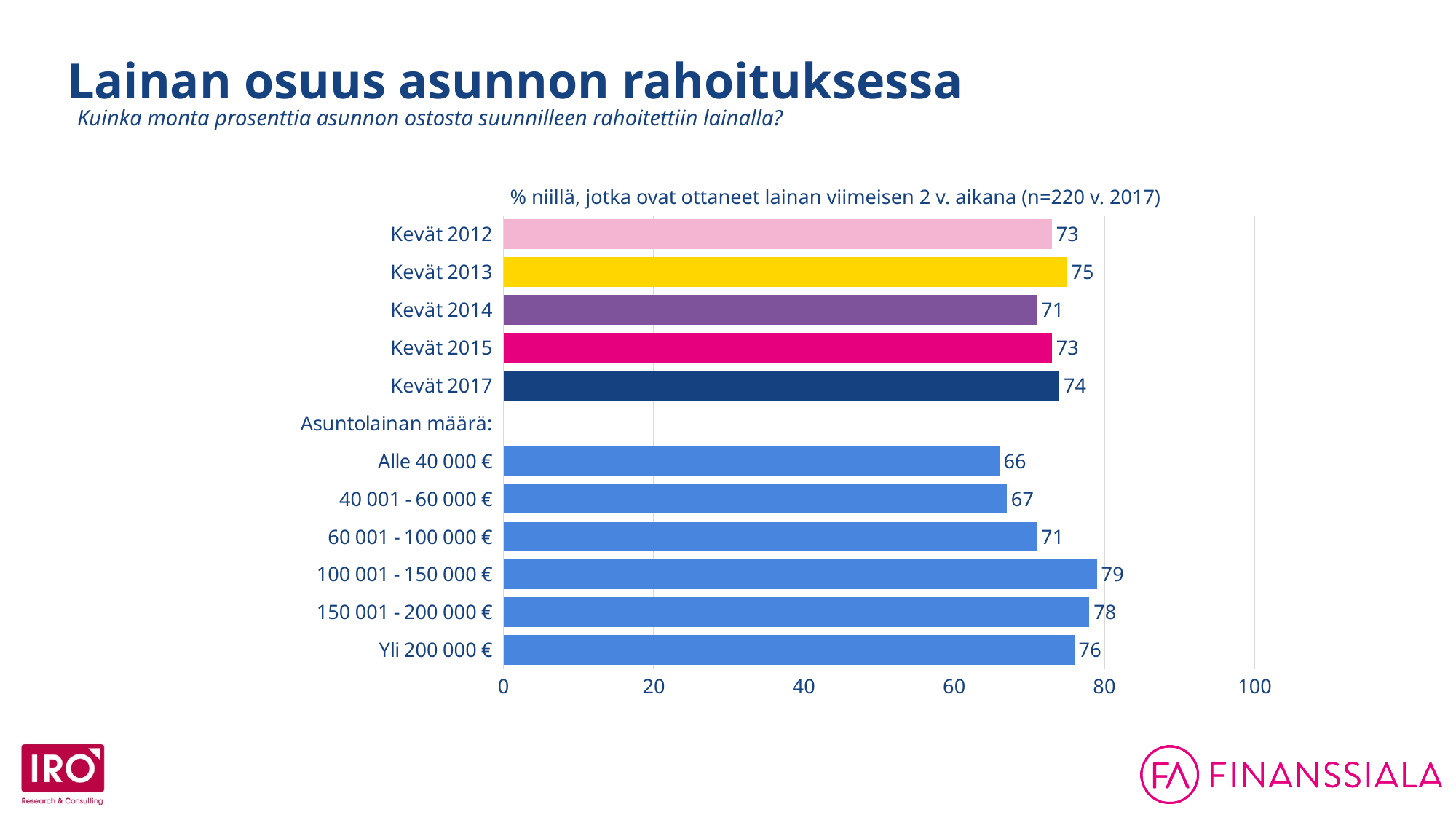
What is the value for Kevät 2013? 75 What is the value for the 100 001 - 150 000 € loan amount category? 79 Which is larger, the value for Kevät 2017 or the value for Kevät 2014? Kevät 2017 Which category has the lowest value on the chart? Alle 40 000 € How many bars are plotted on the chart? 11 What is the title of the chart? % niillä, jotka ovat ottaneet lainan viimeisen 2 v. aikana (n=220 v. 2017) Is the value for 150 001 - 200 000 € greater or less than 60? greater What is the difference between the values for Yli 200 000 € and Alle 40 000 €? 10 What is the difference between the values for Kevät 2013 and Kevät 2014? 4 What is the value for Alle 40 000 €? 66 Which category has the highest value on the chart? 100 001 - 150 000 € What kind of chart is shown on the slide? bar chart